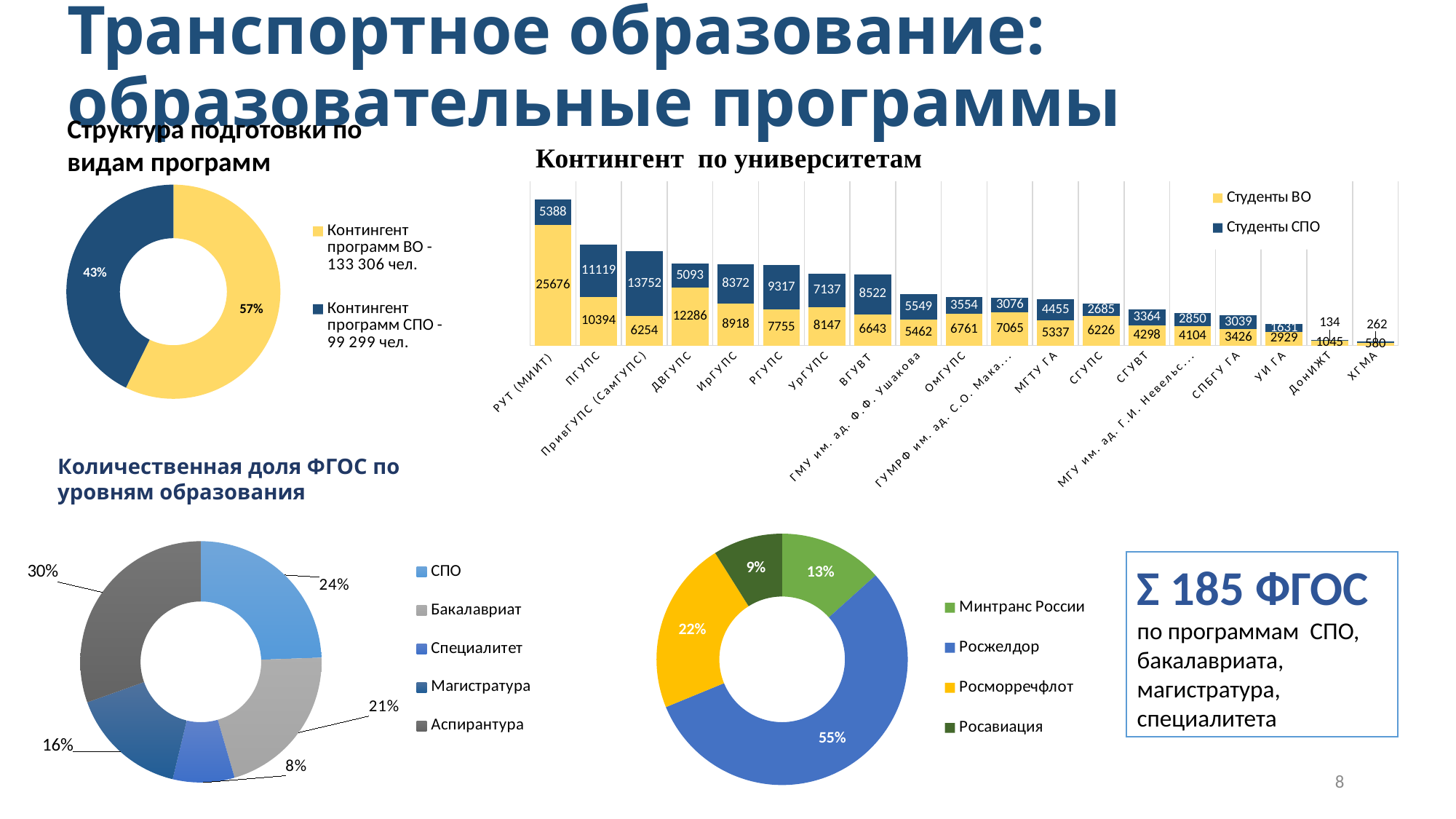
In the chart 'Контингент по университетам', what is the value for Студенты ВО at РУТ (МИИТ)? 25676 In the chart 'Контингент по университетам', what is the difference between Студенты ВО and Студенты СПО at ДВГУПС? 7193 In the chart 'Количественная доля ФГОС по уровням образования', which category has the largest share? Аспирантура In the chart 'Контингент по университетам', which university has the highest number of Студенты ВО? РУТ (МИИТ) In the bottom-right donut chart, what share is shown for Росжелдор? 55% In the chart 'Контингент по университетам', what is the total of the stacked bar for ПГУПС? 21513 In the chart 'Структура подготовки по видам программ', what share is shown for Контингент программ СПО? 43% In the chart 'Контингент по университетам', what is the value for Студенты СПО at ПривГУПС (СамГУПС)? 13752 In the chart 'Количественная доля ФГОС по уровням образования', what share is shown for Специалитет? 8% In the chart 'Контингент по университетам', what kind of chart is used? Stacked bar chart In the chart 'Контингент по университетам', how many series does the legend list? 2